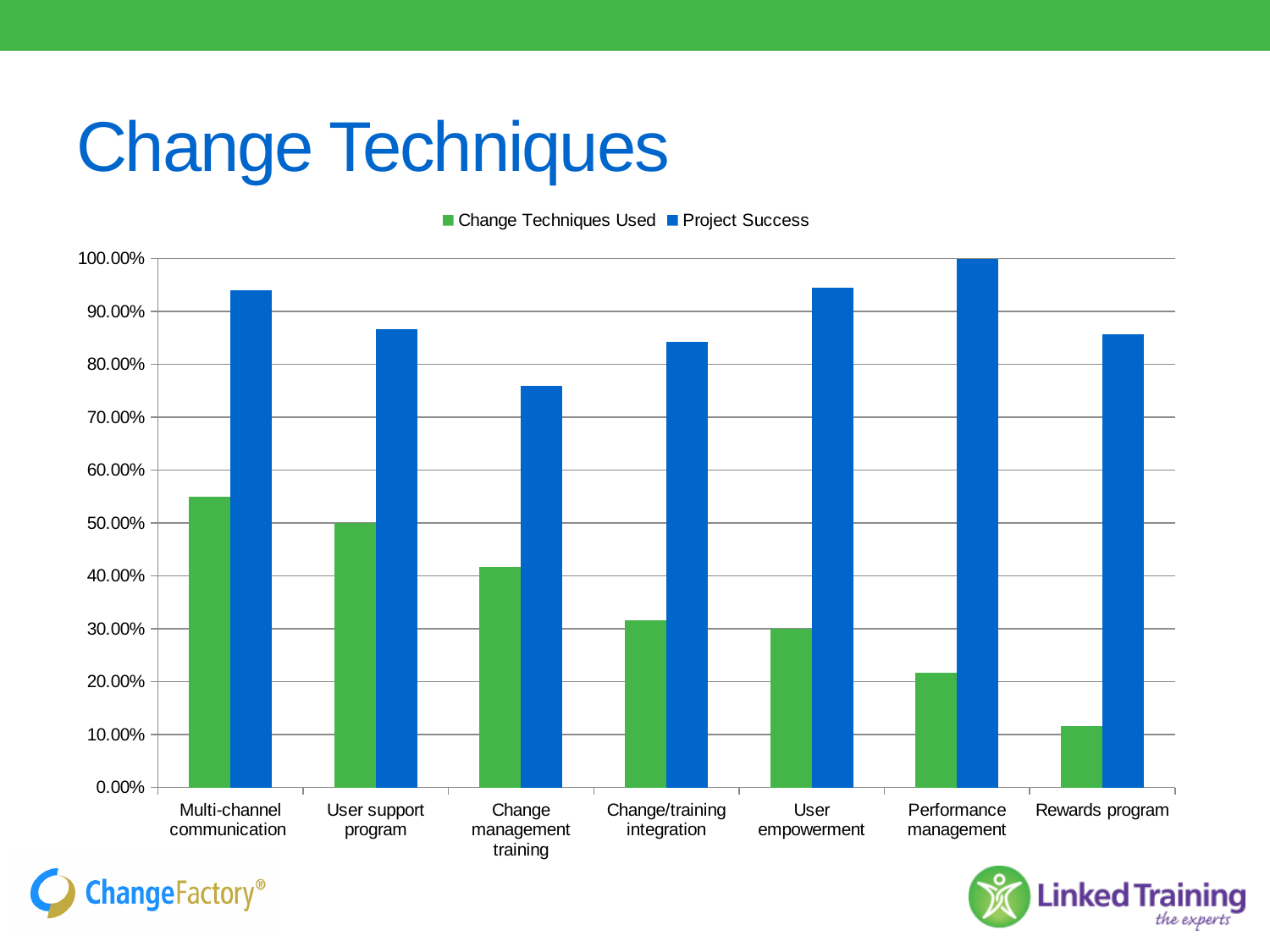
Is the Project Success value for Change management training greater or less than 70.00%? greater Is the Change Techniques Used value for Rewards program greater or less than 20.00%? less How many change techniques are shown on the x axis? 7 What colour represents the Project Success series? Blue Which change technique has the lowest Change Techniques Used value? Rewards program Which has the larger Project Success value, Multi-channel communication or User support program? Multi-channel communication Do the Change Techniques Used values rise or fall from left to right along the x axis? fall Which change technique has the highest Project Success value? Performance management How many series does the legend list? 2 Which change technique has the lowest Project Success value? Change management training Which change technique has the highest Change Techniques Used value? Multi-channel communication What kind of chart is shown on the slide? Bar chart